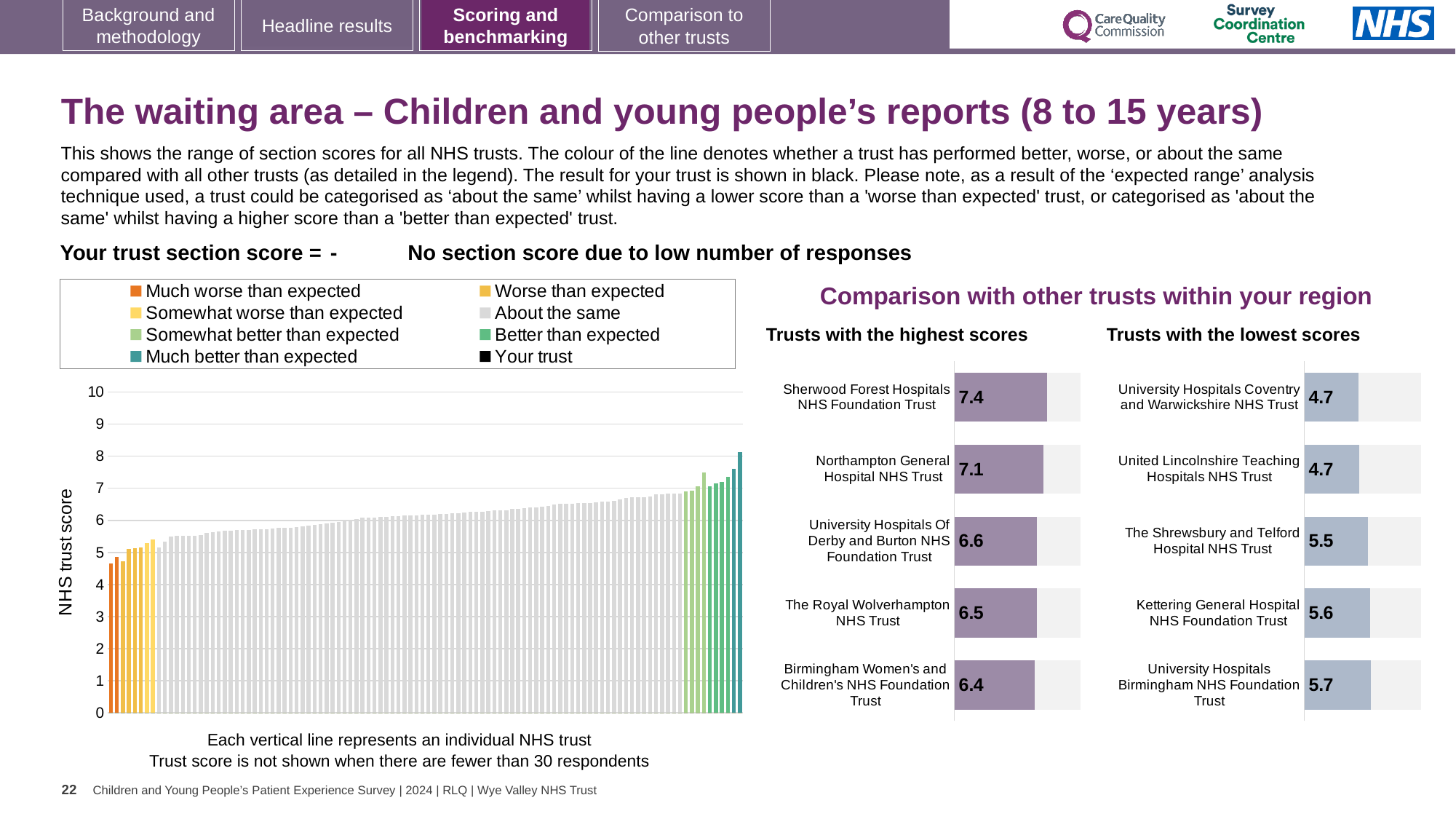
In the 'Trusts with the lowest scores' chart, which trust has the highest score? University Hospitals Birmingham NHS Foundation Trust In the 'Trusts with the lowest scores' chart, what is the score for The Shrewsbury and Telford Hospital NHS Trust? 5.5 In the 'Trusts with the highest scores' chart, which has the higher score: University Hospitals Of Derby and Burton NHS Foundation Trust or The Royal Wolverhampton NHS Trust? University Hospitals Of Derby and Burton NHS Foundation Trust In the 'Trusts with the highest scores' chart, what is the score for The Royal Wolverhampton NHS Trust? 6.5 In the large chart on the left showing all NHS trusts, is the value of the lowest bar greater or less than 5? less In the 'Trusts with the highest scores' chart, what is the score for Sherwood Forest Hospitals NHS Foundation Trust? 7.4 How many entries does the legend above the large chart on the left list? 8 In the 'Trusts with the lowest scores' chart, what is the score for University Hospitals Birmingham NHS Foundation Trust? 5.7 In the 'Trusts with the highest scores' chart, what is the difference between the scores of Sherwood Forest Hospitals NHS Foundation Trust and Northampton General Hospital NHS Trust? 0.3 In the 'Trusts with the lowest scores' chart, what is the difference between the scores of Kettering General Hospital NHS Foundation Trust and United Lincolnshire Teaching Hospitals NHS Trust? 0.9 How many trusts are shown in the 'Trusts with the lowest scores' chart? 5 In the 'Trusts with the highest scores' chart, which trust has the lowest score? Birmingham Women's and Children's NHS Foundation Trust